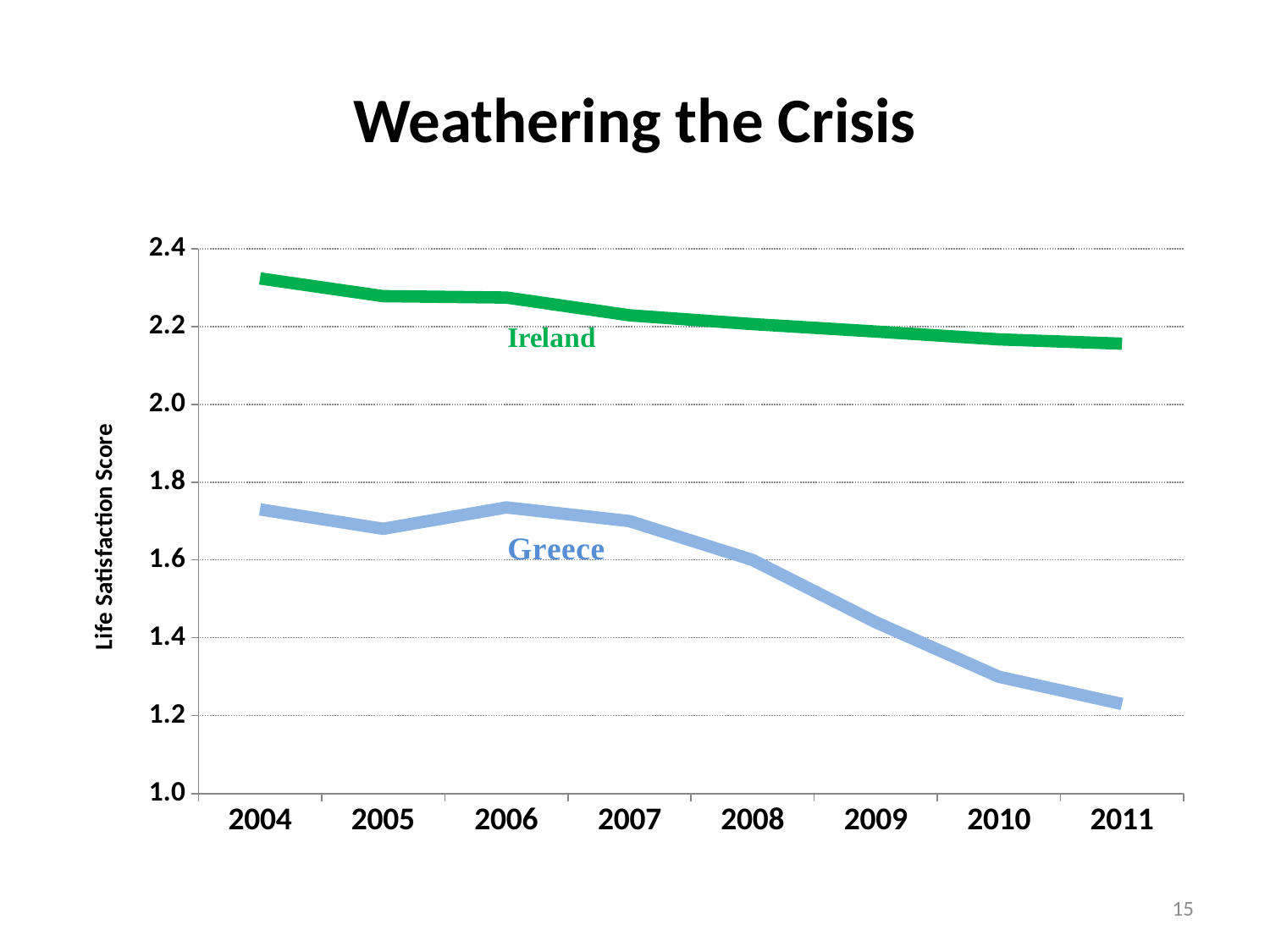
What is the label of the y axis? Life Satisfaction Score In which year is Ireland's life satisfaction score highest? 2004 What kind of chart is shown on the slide? line chart Which country has the higher life satisfaction score in 2011, Ireland or Greece? Ireland Is the value for Greece in 2004 greater or less than 1.8? less How many years are shown along the x axis? 8 Is the value for Ireland in 2004 greater or less than 2.2? greater What is the title of the chart slide? Weathering the Crisis How many series (countries) are plotted on the chart? 2 Does the life satisfaction score for Greece rise or fall between 2007 and 2011? fall In which year is Greece's life satisfaction score lowest? 2011 Is the value for Greece in 2011 greater or less than 1.4? less